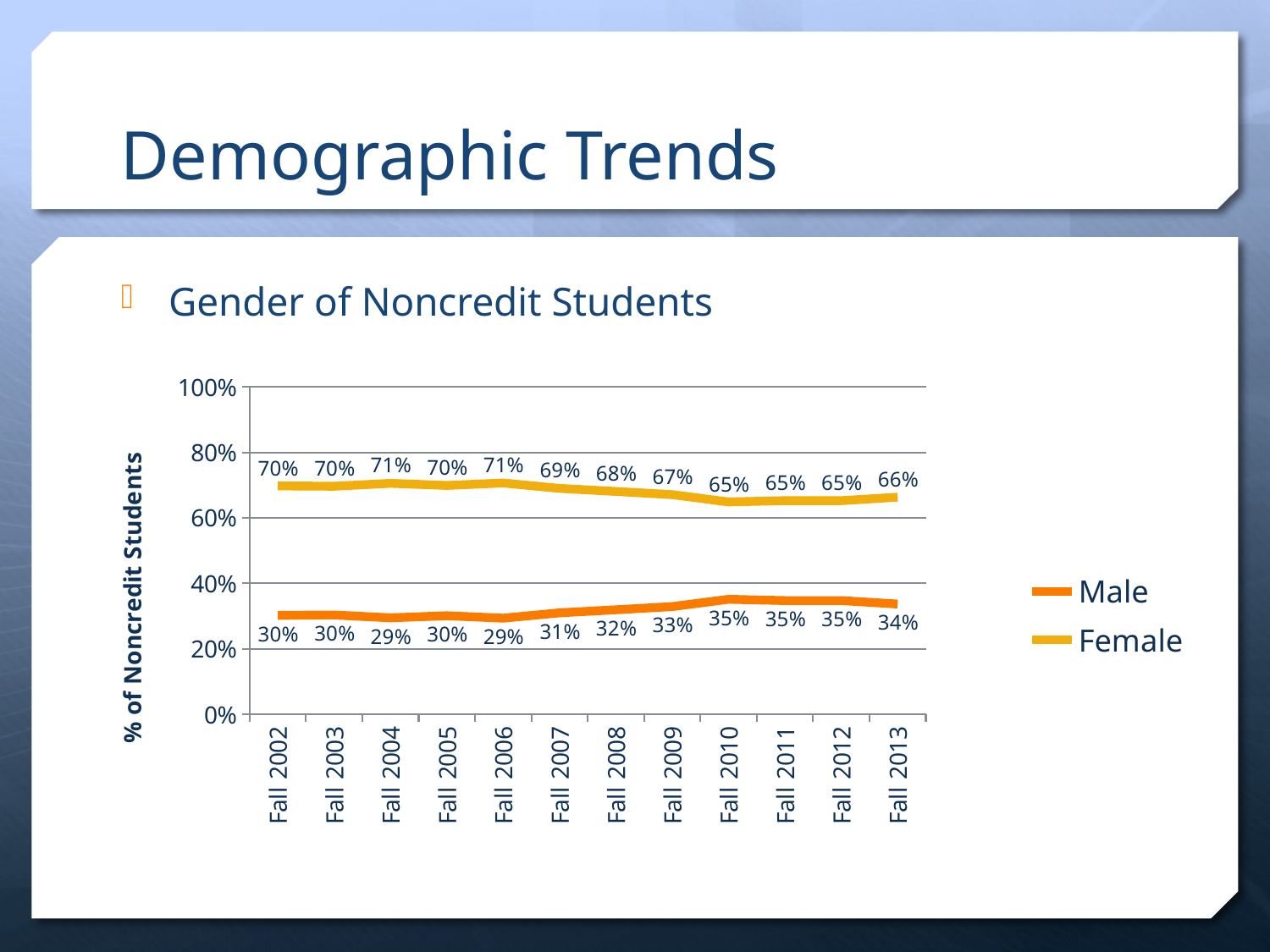
How many series does the legend list? 2 What is the lowest value shown for the Male series? 29% What kind of chart is shown on the slide? Line chart How many time points are plotted on the x axis? 12 What is the Male value for Fall 2010? 35% Does the Male series generally rise or fall from Fall 2002 to Fall 2013? Rise What is the Female value for Fall 2009? 67% What is the Male value for Fall 2013? 34% In which year(s) does the Female series reach its highest value? Fall 2004 and Fall 2006 Which is larger in Fall 2008, the Male value or the Female value? Female What is the Female value for Fall 2002? 70% What is the difference between the Female and Male values in Fall 2013? 32%